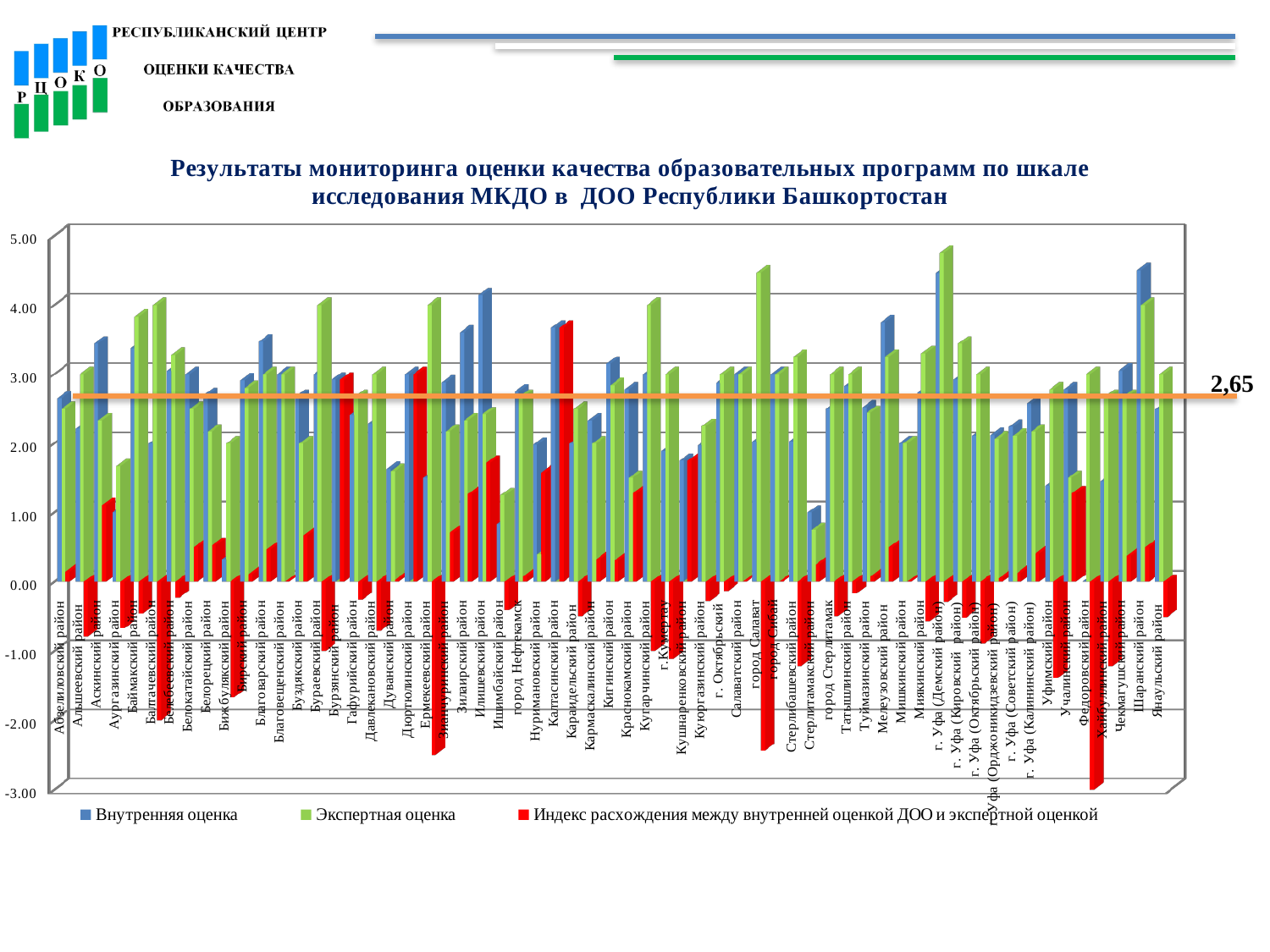
Which category has the lowest (most negative) value of the red 'Индекс расхождения' series? Федоровский район Is the 'Экспертная оценка' value for город Салават greater or less than 4.00? greater How many series does the legend list? 3 Which series is shown in red in the legend? Индекс расхождения между внутренней оценкой ДОО и экспертной оценкой For Илишевский район, which is larger: 'Внутренняя оценка' or 'Экспертная оценка'? Внутренняя оценка For город Салават, which is larger: 'Внутренняя оценка' or 'Экспертная оценка'? Экспертная оценка Is the 'Внутренняя оценка' value for Стерлитамакский район greater or less than 2.00? less Is the 'Экспертная оценка' value for г. Уфа (Демский район) greater or less than 4.00? greater Which colour represents the series 'Экспертная оценка'? Green What value is labelled on the horizontal orange reference line across the chart? 2,65 What kind of chart is shown on the slide? Bar chart